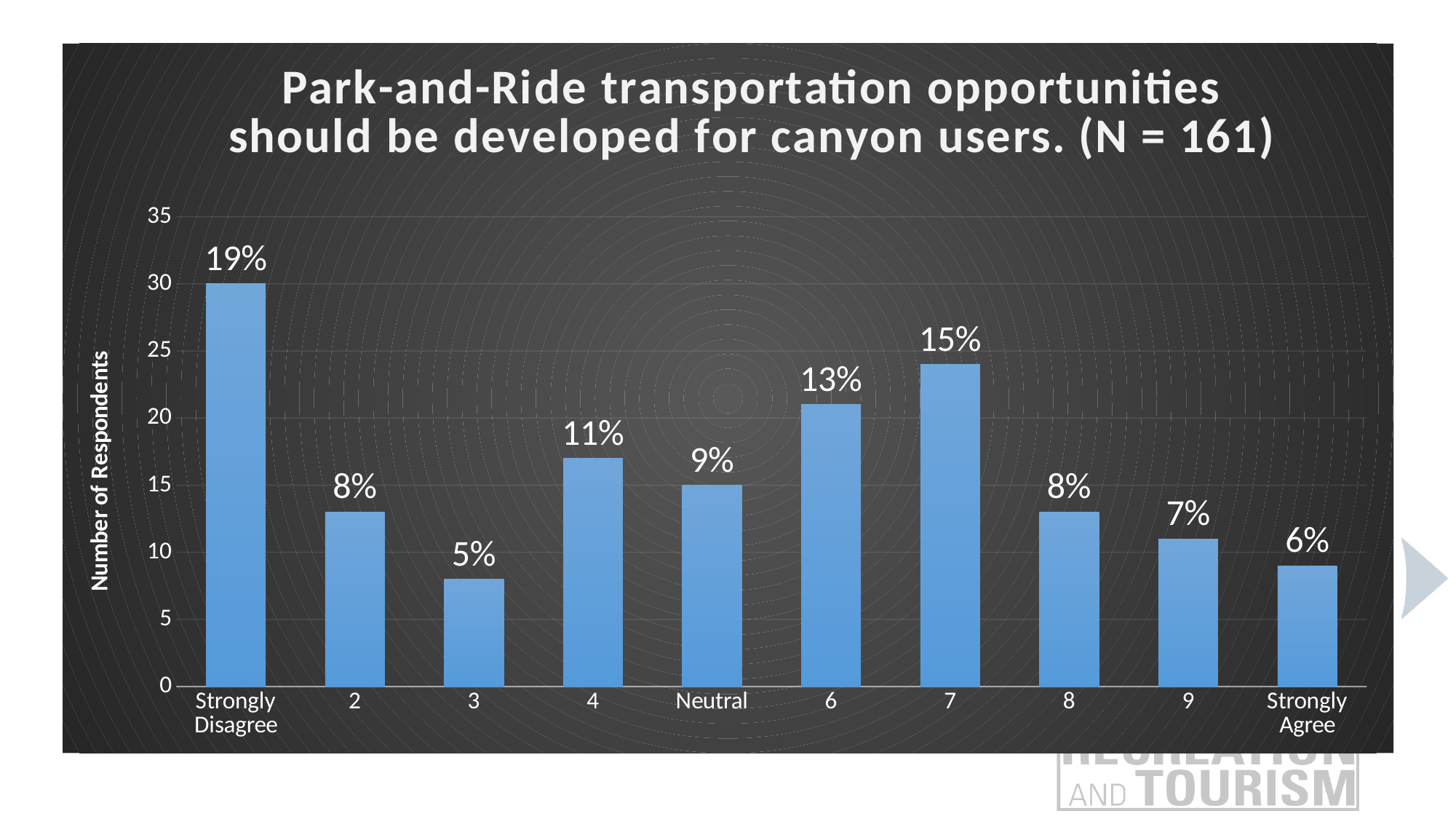
Which bar is taller, category 6 or category 4? 6 What percentage label is shown for category 7? 15% Is the number of respondents for category 7 greater or less than 20? greater What is the difference in percentage points between the Strongly Disagree label and the Strongly Agree label? 13 What percentage label is shown for the Neutral bar? 9% Is the number of respondents for category 3 greater or less than 10? less How many categories are shown on the x axis? 10 Which category has the lowest bar? 3 What percentage label is shown for the Strongly Disagree bar? 19% What percentage label is shown for the Strongly Agree bar? 6% What type of chart is shown on the slide? Bar chart Which category has the highest bar? Strongly Disagree